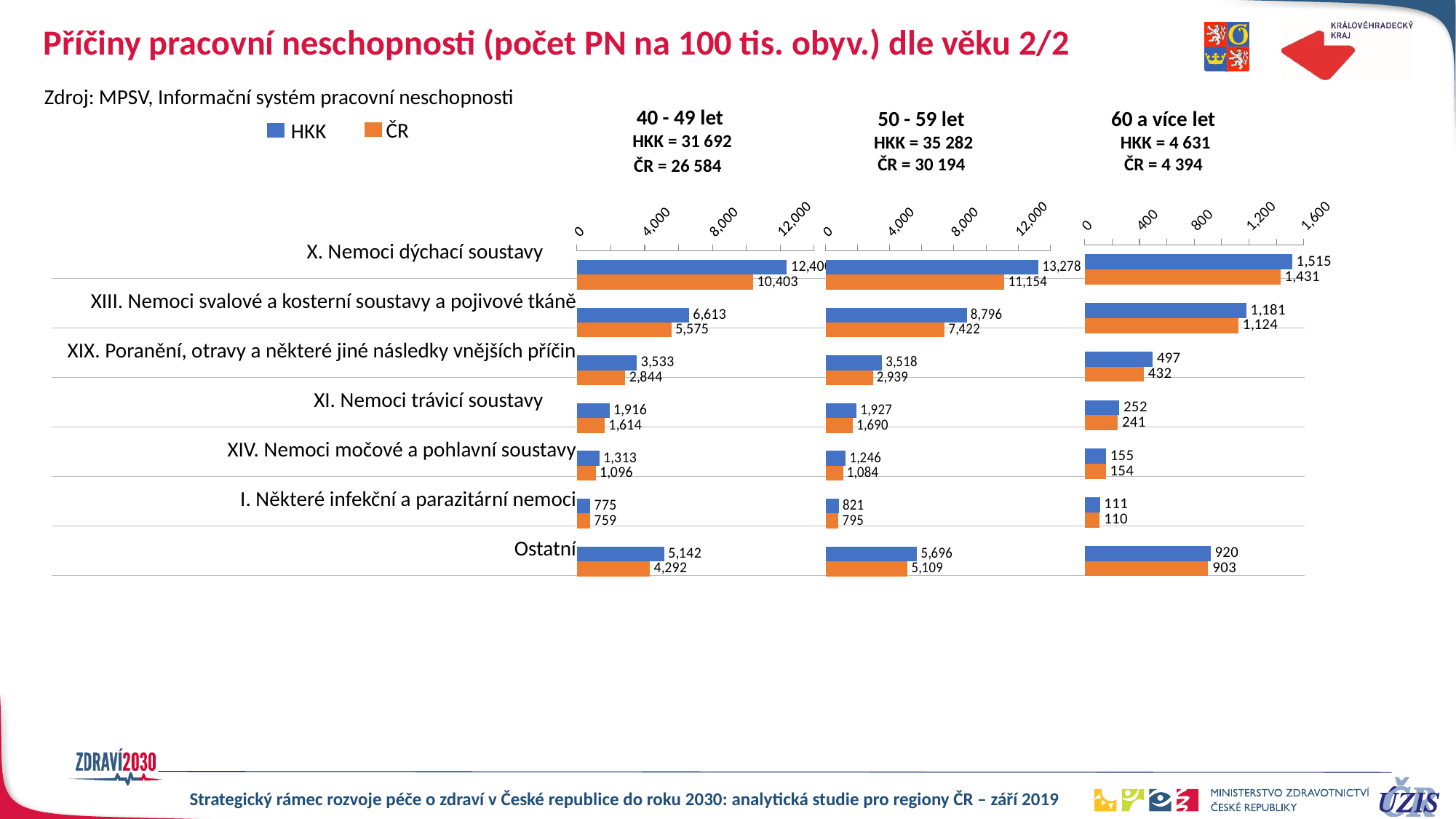
What type of chart is the '50 - 59 let' chart? bar chart In the '40 - 49 let' chart, what is the ČR value for Ostatní? 4,292 In the '60 a více let' chart, what is the ČR value for XIII. Nemoci svalové a kosterní soustavy a pojivové tkáně? 1,124 How many series does the legend list? 2 In the '50 - 59 let' chart, what is the HKK value for X. Nemoci dýchací soustavy? 13,278 In the '40 - 49 let' chart, is the HKK value for X. Nemoci dýchací soustavy greater or less than 12,000? greater How many categories are shown in the '60 a více let' chart? 7 In the '50 - 59 let' chart, what is the difference between the HKK and ČR values for XIII. Nemoci svalové a kosterní soustavy a pojivové tkáně? 1,374 In the '50 - 59 let' chart, which category has the highest ČR value? X. Nemoci dýchací soustavy In the '40 - 49 let' chart, which category has the lowest HKK value? I. Některé infekční a parazitární nemoci Which colour represents the ČR series in the charts? orange In the '60 a více let' chart, which is larger for XIX. Poranění, otravy a některé jiné následky vnějších příčin: the HKK value or the ČR value? HKK